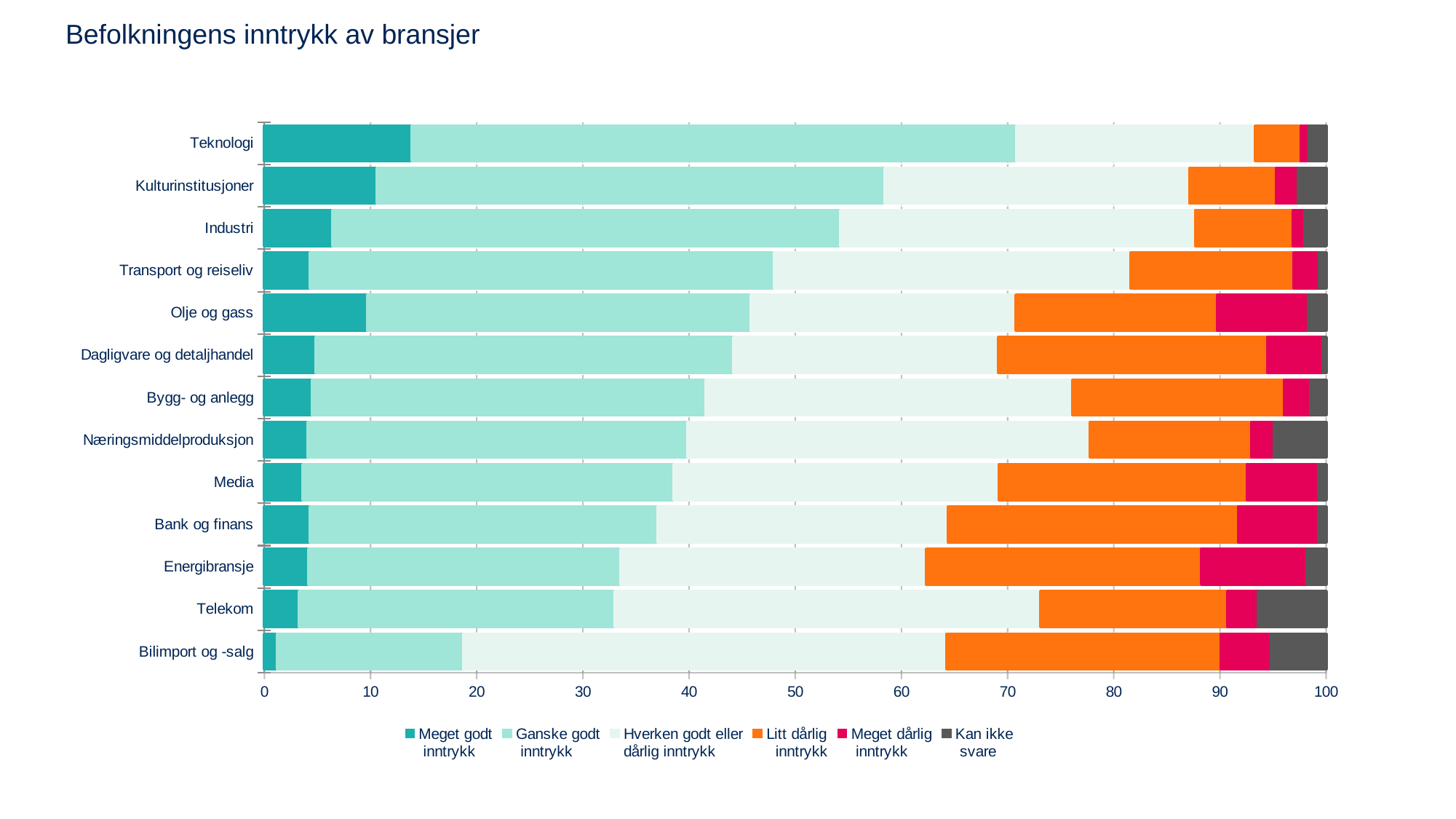
How many industries (categories) are listed on the vertical axis of the chart? 13 How many series does the legend of the chart list? 6 Which industry has the largest 'Kan ikke svare' segment? Telekom Which has the larger 'Meget dårlig inntrykk' segment, Olje og gass or Teknologi? Olje og gass Which legend entry is shown in orange? Litt dårlig inntrykk What is the title of the chart on the slide? Befolkningens inntrykk av bransjer Which industry has the smallest 'Meget godt inntrykk' segment? Bilimport og -salg Is the 'Meget godt inntrykk' value for Teknologi greater or less than 10? greater What kind of chart is shown on the slide? Stacked bar chart Is the 'Meget godt inntrykk' value for Bilimport og -salg greater or less than 10? less Which has the larger 'Ganske godt inntrykk' segment, Teknologi or Bilimport og -salg? Teknologi Which industry has the largest 'Meget godt inntrykk' segment? Teknologi